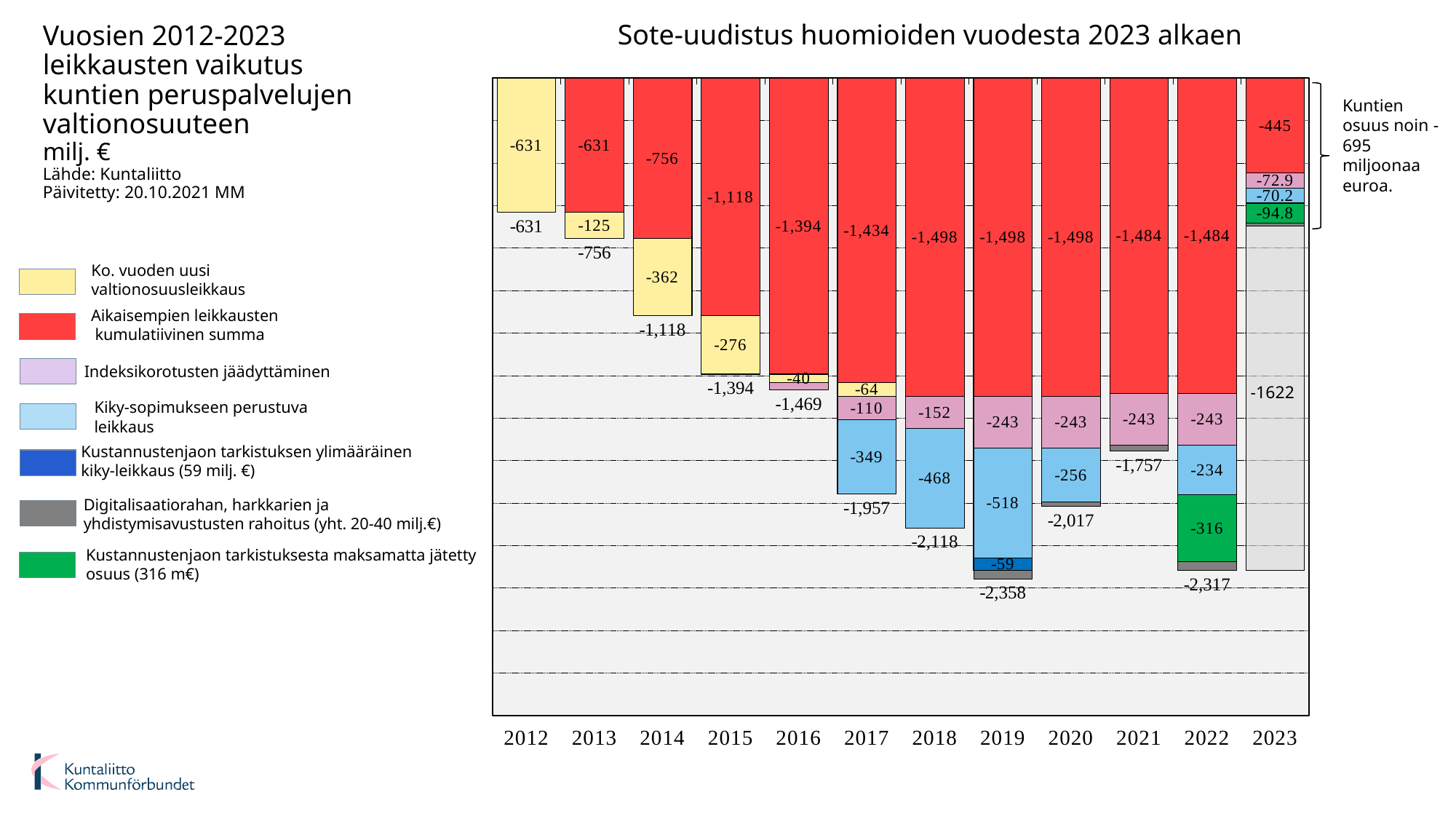
What is the value of the Kiky-sopimukseen perustuva leikkaus segment for 2018? -468 How many years are shown on the x axis of the chart? 12 What kind of chart is shown on the slide? Stacked bar chart What is the value of the Indeksikorotusten jäädyttäminen segment for 2020? -243 What is the difference in absolute value between the total for 2019 (-2,358) and the total for 2018 (-2,118)? 240 How many series does the legend list? 7 What is the value of the Kustannustenjaon tarkistuksen ylimääräinen kiky-leikkaus segment in 2019? -59 What is the title printed above the chart? Sote-uudistus huomioiden vuodesta 2023 alkaen Which year has the larger Kiky-sopimukseen perustuva leikkaus segment in absolute value, 2019 or 2020? 2019 What is the value of the Kustannustenjaon tarkistuksesta maksamatta jätetty osuus segment in 2022? -316 What is the total value labelled below the bar for 2019? -2,358 What is the value of the Ko. vuoden uusi valtionosuusleikkaus segment for 2014? -362